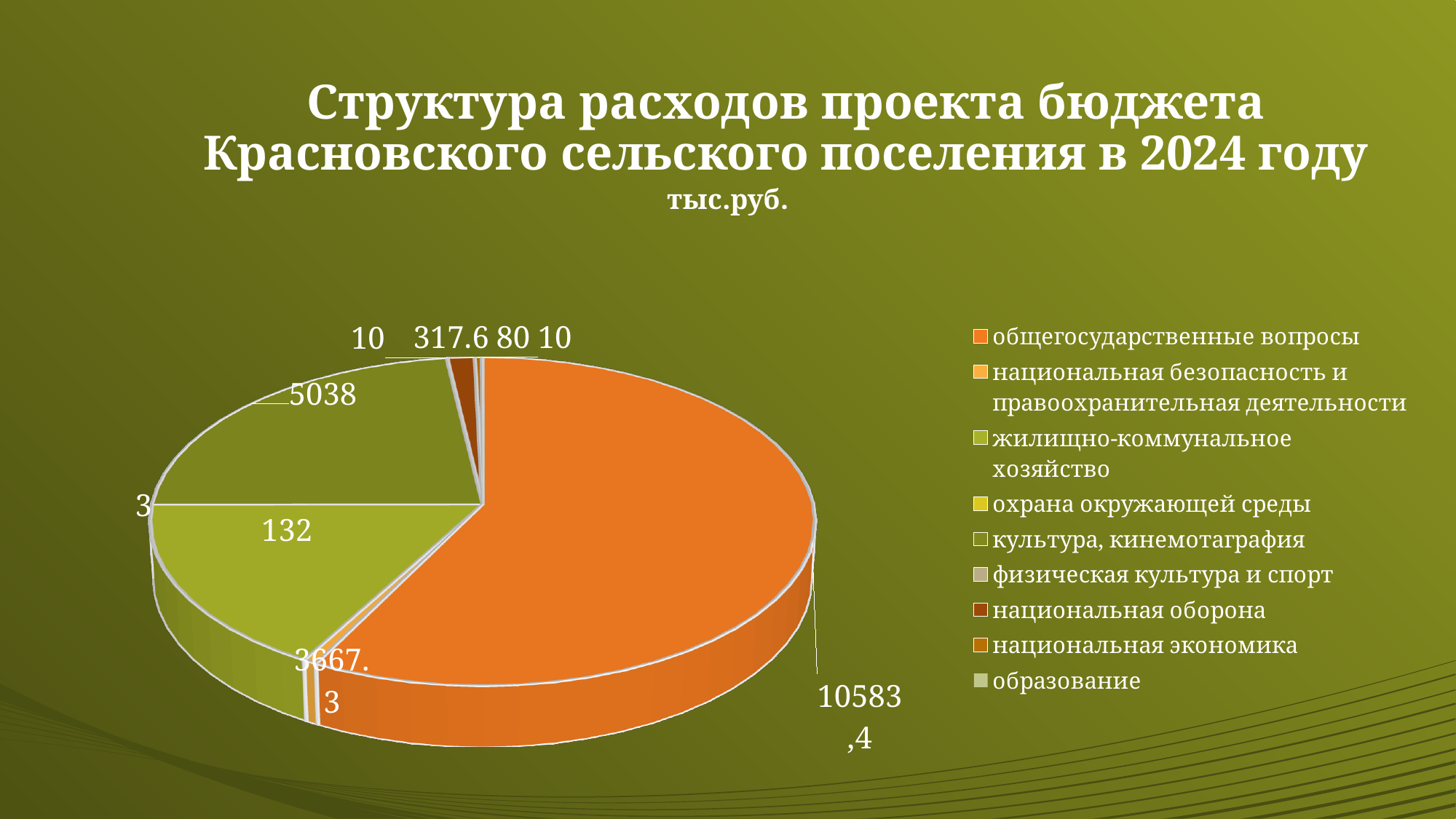
What kind of chart is shown on the slide? Pie chart Which is larger: the slice for общегосударственные вопросы or the slice for культура, кинемотаграфия? общегосударственные вопросы What is the largest value labelled on the pie chart? 10583,4 What is the title of the chart on the slide? Структура расходов проекта бюджета Красновского сельского поселения в 2024 году Which is larger: the slice for общегосударственные вопросы or the slice for жилищно-коммунальное хозяйство? общегосударственные вопросы In what units are the values of the chart given, according to the subtitle? тыс.руб. What value is labelled on the slice for общегосударственные вопросы? 10583,4 How many categories does the legend of the pie chart list? 9 Which category has the largest slice in the pie chart? общегосударственные вопросы